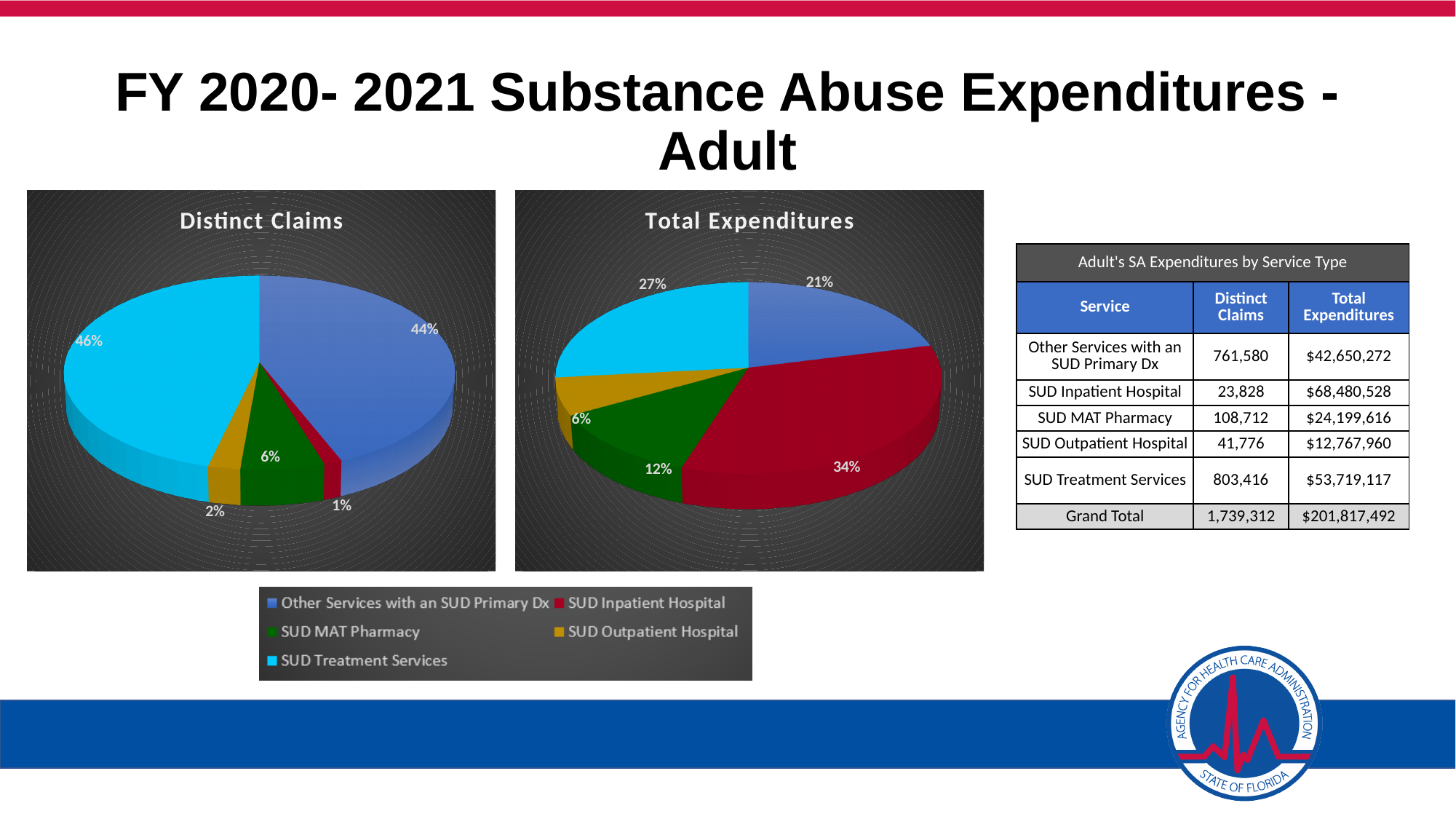
In the "Total Expenditures" chart, what share of the pie is SUD Inpatient Hospital? 34% In the "Distinct Claims" chart, what share of the pie is SUD Inpatient Hospital? 1% In the "Total Expenditures" chart, what share of the pie is SUD MAT Pharmacy? 12% What type of chart is the "Distinct Claims" chart? pie chart In the "Total Expenditures" chart, which category has the smallest slice? SUD Outpatient Hospital How many categories does the legend list for the pie charts? 5 In the "Total Expenditures" chart, what is the difference in percentage points between SUD Treatment Services and Other Services with an SUD Primary Dx? 6 In the "Total Expenditures" chart, which category has the largest slice? SUD Inpatient Hospital In the "Distinct Claims" chart, which is larger: SUD MAT Pharmacy or SUD Outpatient Hospital? SUD MAT Pharmacy In the "Distinct Claims" chart, which category has the smallest slice? SUD Inpatient Hospital